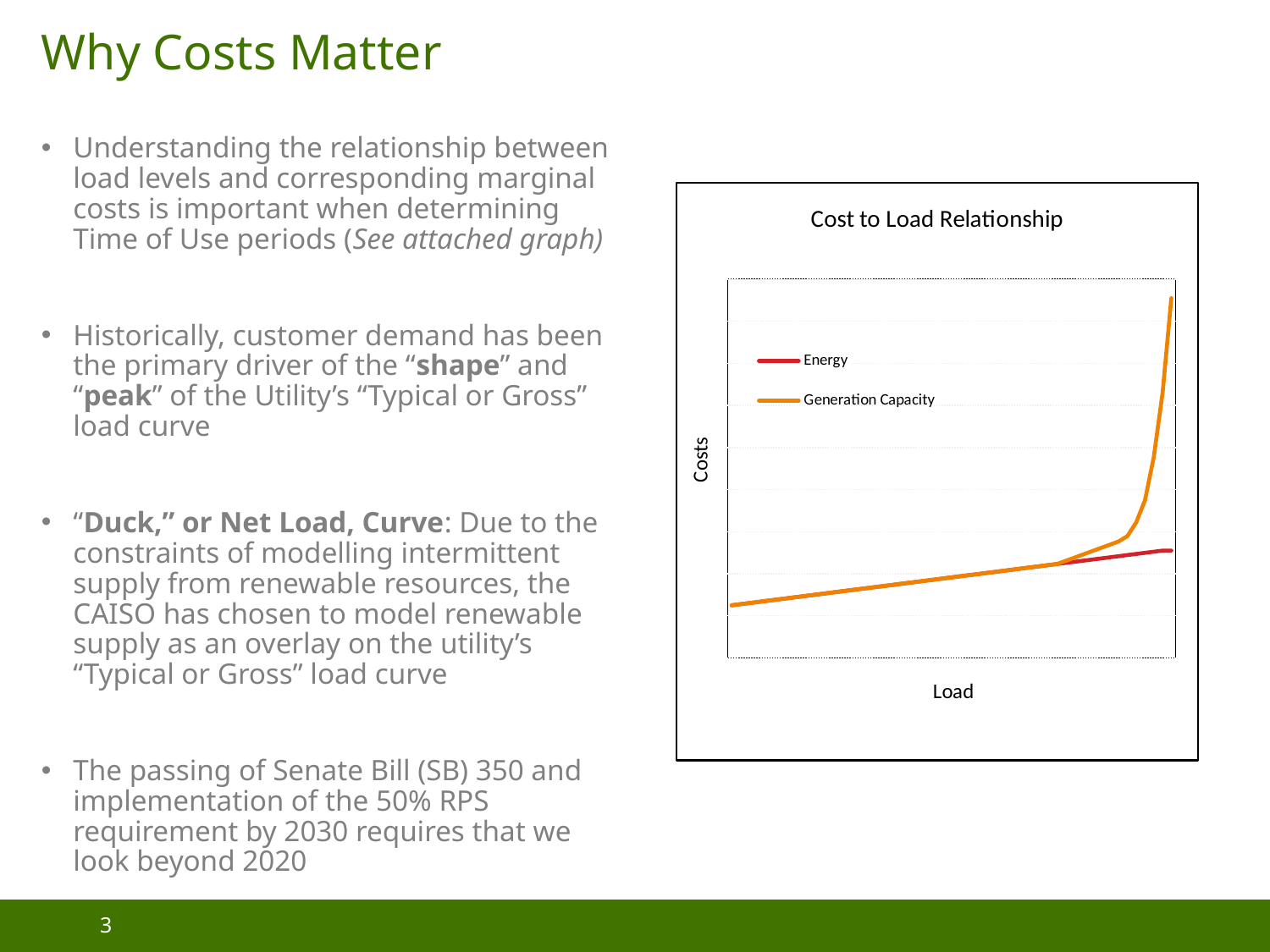
At the highest Load shown, which series has the higher cost, Energy or Generation Capacity? Generation Capacity Which series shows a sharp upward spike at the right end of the chart? Generation Capacity Do the values of the Energy series rise or fall as Load increases? Rise What are the two series named in the chart's legend? Energy and Generation Capacity Which series reaches the highest cost on the chart? Generation Capacity What is the title of the chart? Cost to Load Relationship What is the label on the horizontal axis of the chart? Load Do the values of the Generation Capacity series rise or fall as Load increases? Rise How many series does the chart's legend list? 2 What kind of chart is shown on the slide? Line chart